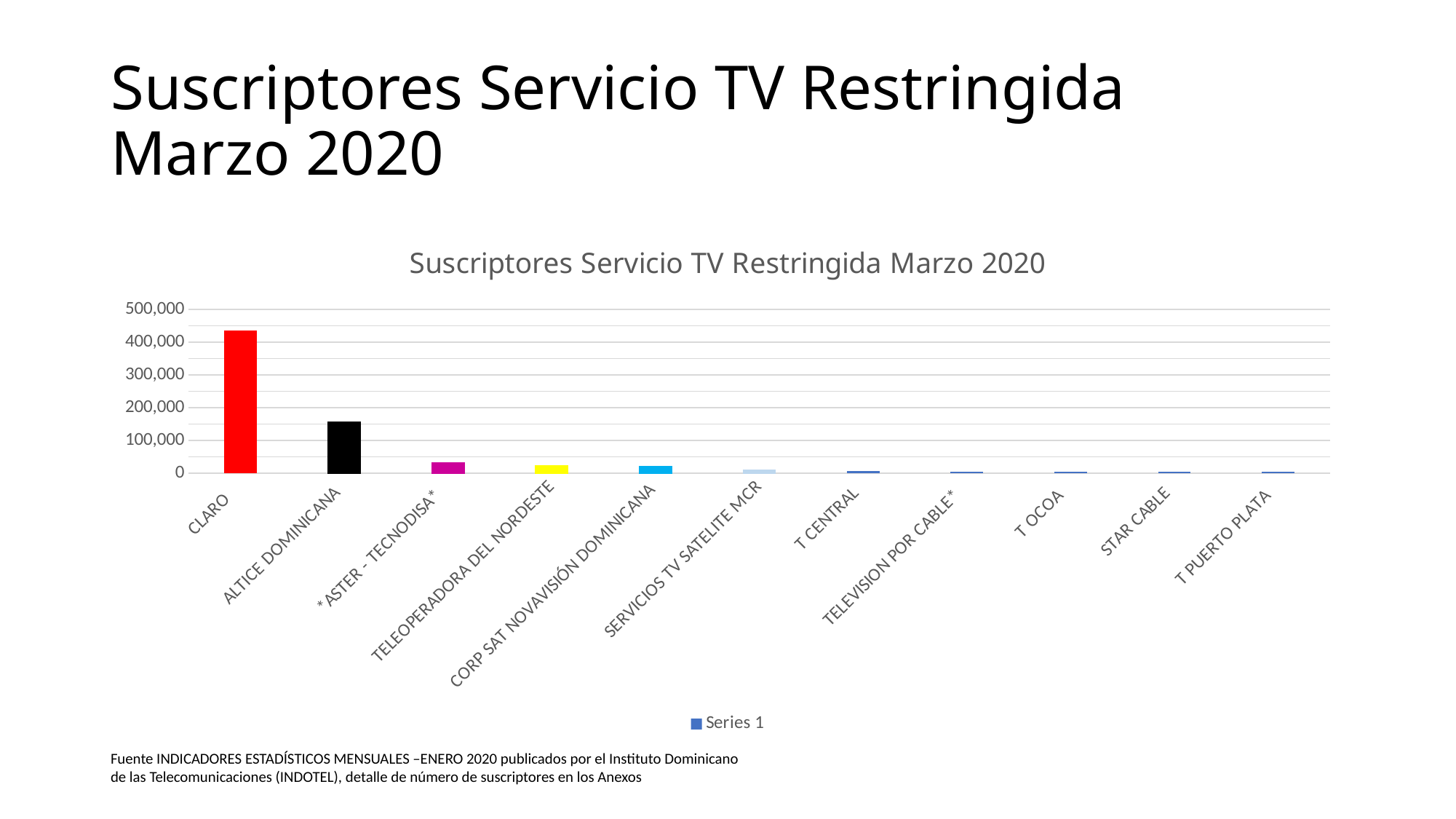
Do the values generally rise or fall moving from left to right along the x axis? fall Which operator has the highest number of subscribers in the chart? CLARO How many categories (operators) are shown on the x axis of the chart? 11 How many series does the chart legend list? 1 Is the value for ALTICE DOMINICANA greater or less than 200,000? less Is the value for CLARO greater or less than 400,000? greater Which has more subscribers, CLARO or ALTICE DOMINICANA? CLARO What is the title of the chart? Suscriptores Servicio TV Restringida Marzo 2020 Is the value for * ASTER - TECNODISA * greater or less than 100,000? less What kind of chart is shown on the slide? bar chart What is the name of the series shown in the legend? Series 1